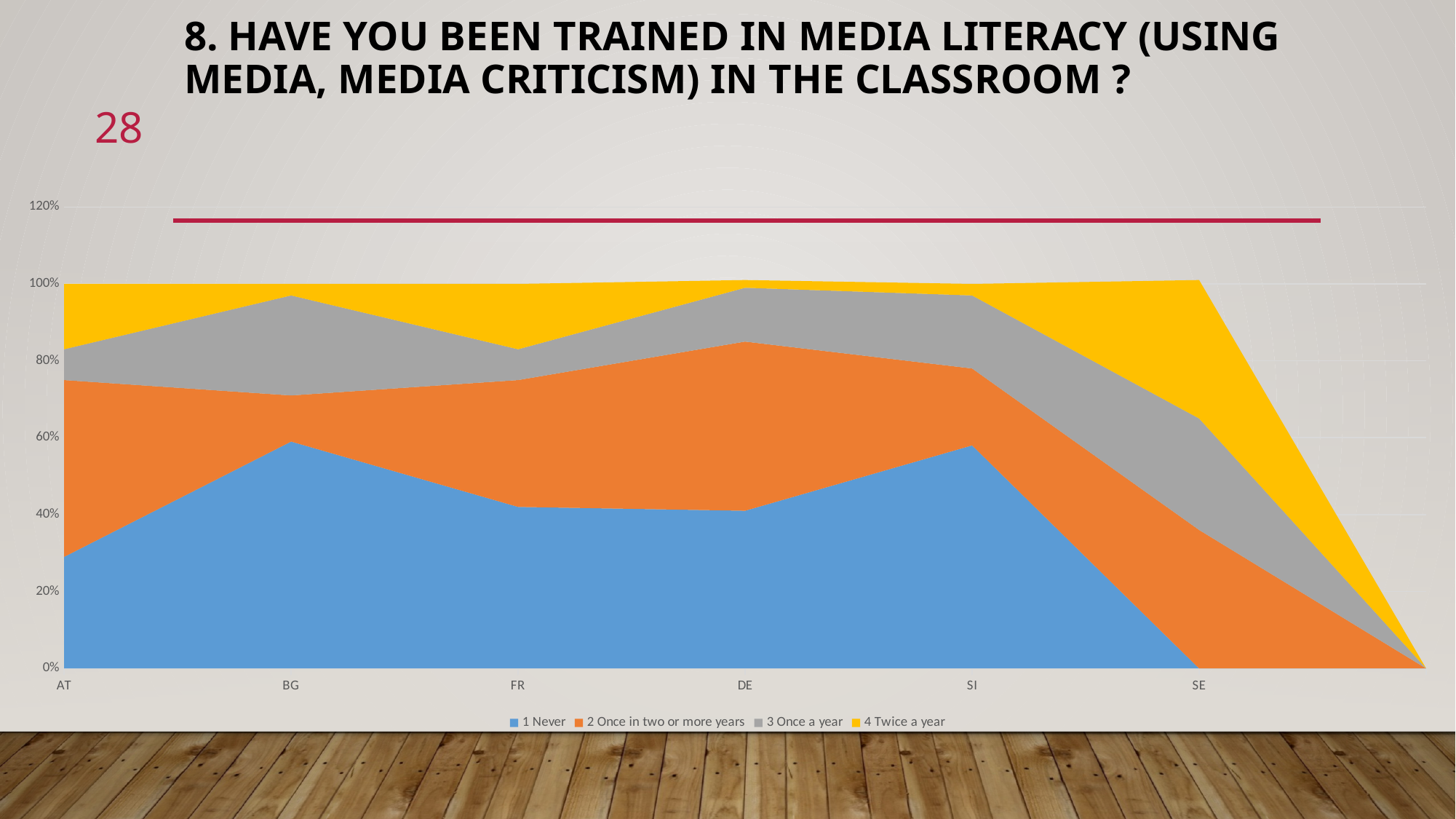
Which has the larger value for '1 Never', AT or BG? BG Which colour represents the '1 Never' series? Blue Which country has the lowest value for the '1 Never' series? SE Is the value for '1 Never' at BG greater or less than 40%? greater Which has the larger value for '1 Never', AT or FR? FR How many country categories are labelled on the x axis? 6 What is the legend label of the yellow series? 4 Twice a year Is the value for '1 Never' at SE greater or less than 20%? less Is the value for '1 Never' at AT greater or less than 40%? less How many series does the legend list? 4 What kind of chart is shown on the slide? Stacked area chart